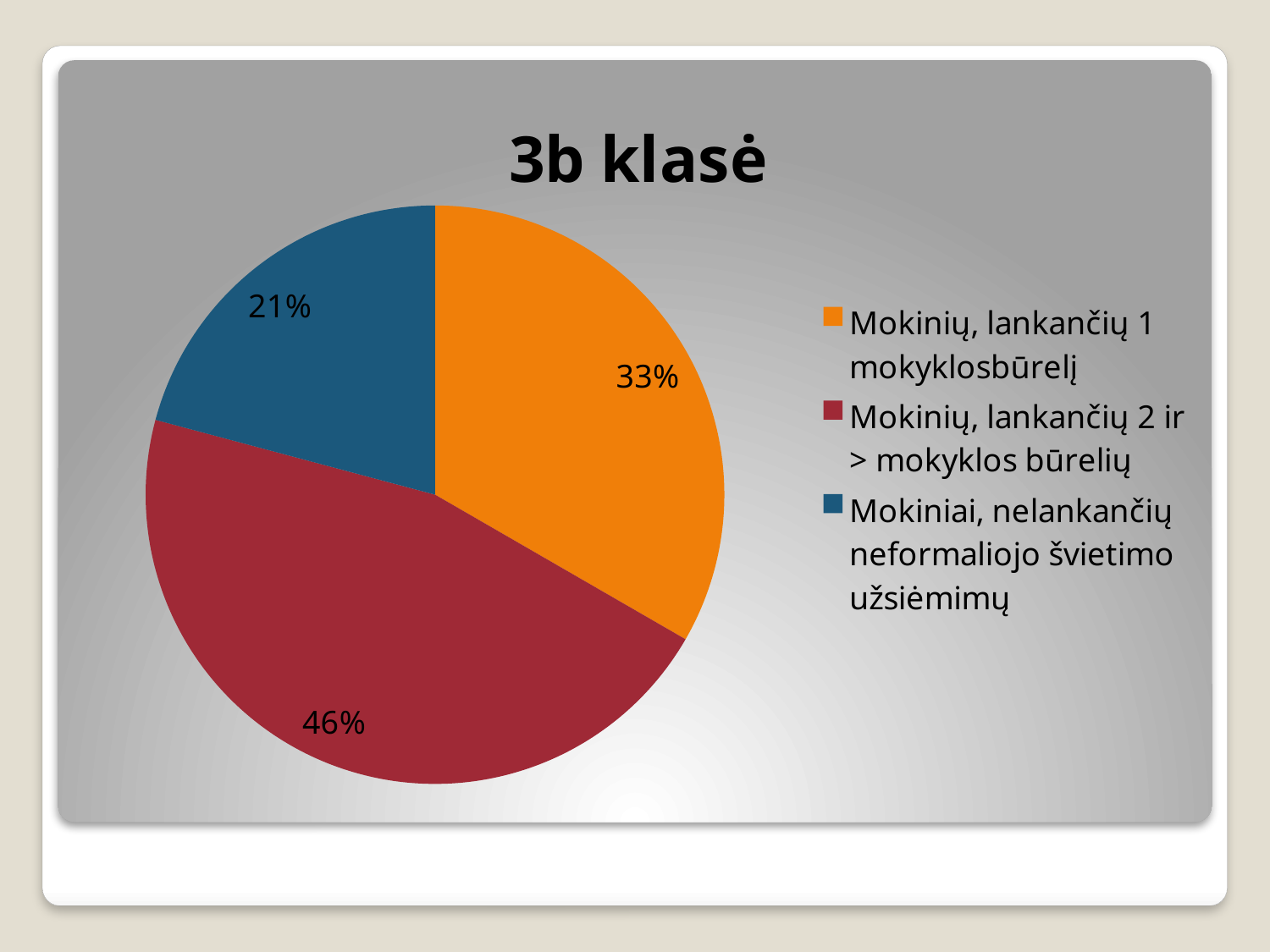
Which category has the largest slice of the pie? Mokinių, lankančių 2 ir > mokyklos būrelių What share of the pie is labelled for "Mokinių, lankančių 2 ir > mokyklos būrelių"? 46% Which category has the smallest slice of the pie? Mokiniai, nelankančių neformaliojo švietimo užsiėmimų What is the title of the chart? 3b klasė What colour is the slice for "Mokiniai, nelankančių neformaliojo švietimo užsiėmimų"? blue What share of the pie is labelled for "Mokiniai, nelankančių neformaliojo švietimo užsiėmimų"? 21% What type of chart is shown on the slide? pie chart What is the difference in percentage points between the slice for "Mokinių, lankančių 2 ir > mokyklos būrelių" and the slice for "Mokinių, lankančių 1 mokyklosbūrelį"? 13 How many entries does the legend list? 3 Which is larger: the slice for "Mokinių, lankančių 1 mokyklosbūrelį" or the slice for "Mokiniai, nelankančių neformaliojo švietimo užsiėmimų"? Mokinių, lankančių 1 mokyklosbūrelį How many slices does the pie chart have? 3 What share of the pie is labelled for "Mokinių, lankančių 1 mokyklosbūrelį"? 33%